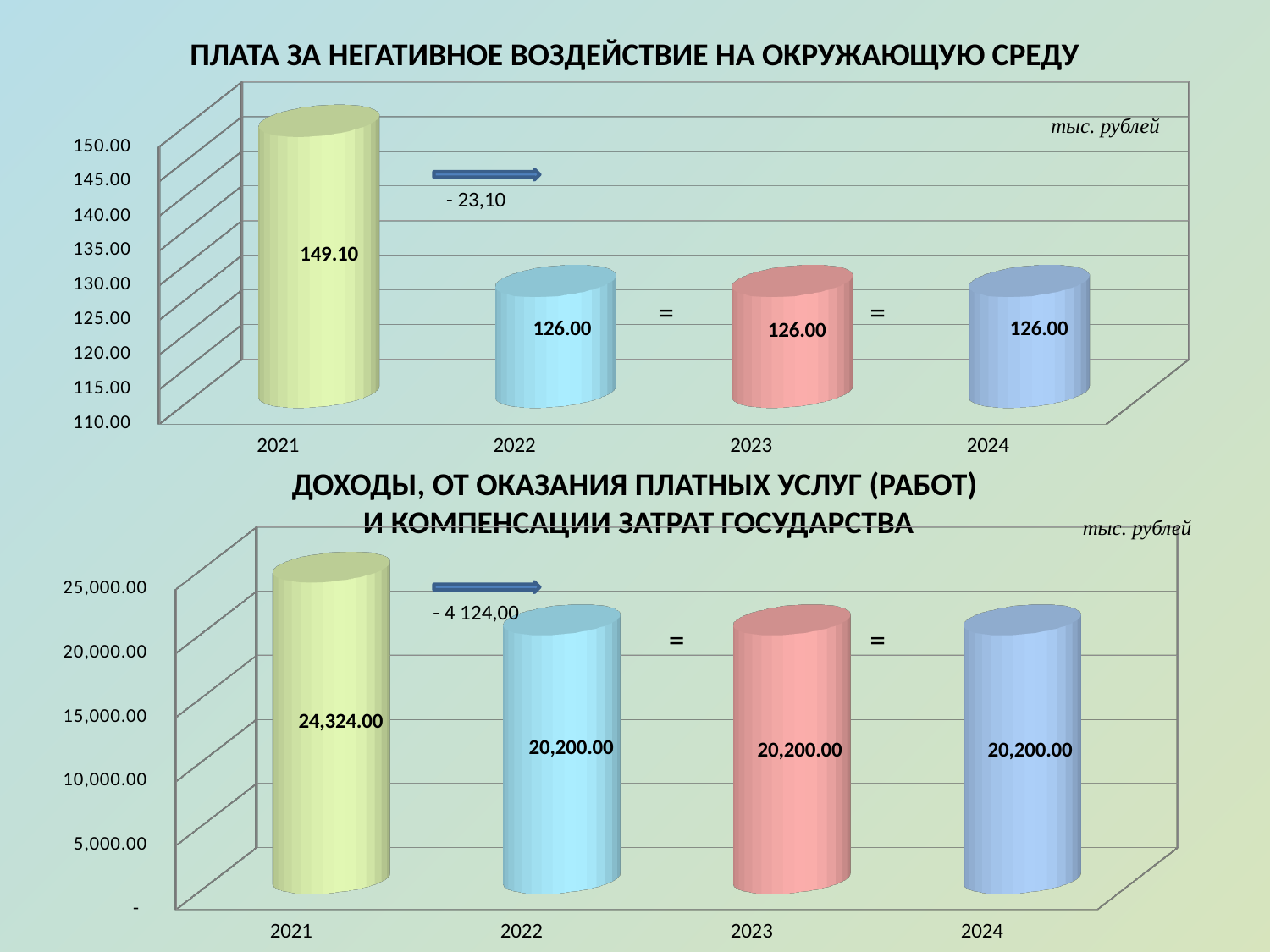
In the top chart (ПЛАТА ЗА НЕГАТИВНОЕ ВОЗДЕЙСТВИЕ НА ОКРУЖАЮЩУЮ СРЕДУ), what is the difference between the 2021 value and the 2022 value? 23.10 In the top chart (ПЛАТА ЗА НЕГАТИВНОЕ ВОЗДЕЙСТВИЕ НА ОКРУЖАЮЩУЮ СРЕДУ), what is the value for 2023? 126.00 In the bottom chart (ДОХОДЫ, ОТ ОКАЗАНИЯ ПЛАТНЫХ УСЛУГ), what is the value for 2024? 20,200.00 In the top chart (ПЛАТА ЗА НЕГАТИВНОЕ ВОЗДЕЙСТВИЕ НА ОКРУЖАЮЩУЮ СРЕДУ), how many years are shown on the x axis? 4 In the bottom chart (ДОХОДЫ, ОТ ОКАЗАНИЯ ПЛАТНЫХ УСЛУГ), what is the value for 2021? 24,324.00 In the bottom chart (ДОХОДЫ, ОТ ОКАЗАНИЯ ПЛАТНЫХ УСЛУГ), what is the difference between the 2021 value and the 2022 value? 4,124.00 In the bottom chart (ДОХОДЫ, ОТ ОКАЗАНИЯ ПЛАТНЫХ УСЛУГ), is the value for 2021 greater or less than 20,000.00? greater In the bottom chart (ДОХОДЫ, ОТ ОКАЗАНИЯ ПЛАТНЫХ УСЛУГ), which is larger, the value for 2021 or the value for 2023? 2021 In the top chart (ПЛАТА ЗА НЕГАТИВНОЕ ВОЗДЕЙСТВИЕ НА ОКРУЖАЮЩУЮ СРЕДУ), what is the value for 2021? 149.10 In the top chart (ПЛАТА ЗА НЕГАТИВНОЕ ВОЗДЕЙСТВИЕ НА ОКРУЖАЮЩУЮ СРЕДУ), which year has the highest value? 2021 In the top chart (ПЛАТА ЗА НЕГАТИВНОЕ ВОЗДЕЙСТВИЕ НА ОКРУЖАЮЩУЮ СРЕДУ), what unit is indicated for the values? тыс. рублей What kind of chart is the bottom chart (ДОХОДЫ, ОТ ОКАЗАНИЯ ПЛАТНЫХ УСЛУГ)? bar chart